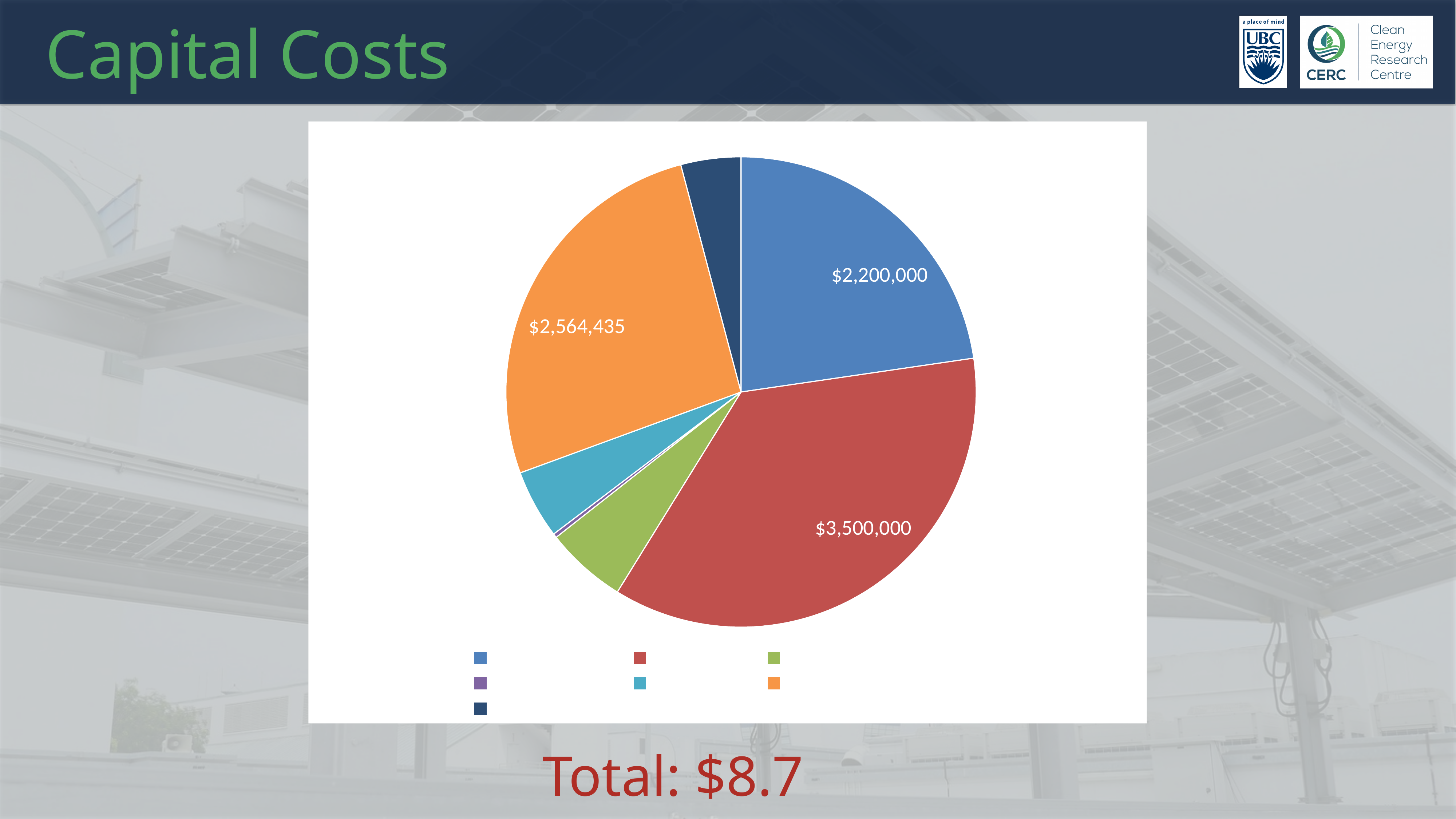
What value is labelled on the orange slice of the pie chart? $2,564,435 What is the title of the slide containing the pie chart? Capital Costs What kind of chart is shown on the slide? pie chart How many entries does the legend below the pie chart list? 7 What value is labelled on the red slice of the pie chart? $3,500,000 Which colour slice is the smallest in the pie chart? purple Which is larger, the orange slice or the blue slice? orange What is the difference between the red slice's value and the blue slice's value? $1,300,000 How many slices does the pie chart have? 7 Which colour slice is the largest in the pie chart? red What is the difference between the orange slice's value and the blue slice's value? $364,435 What value is labelled on the blue slice of the pie chart? $2,200,000